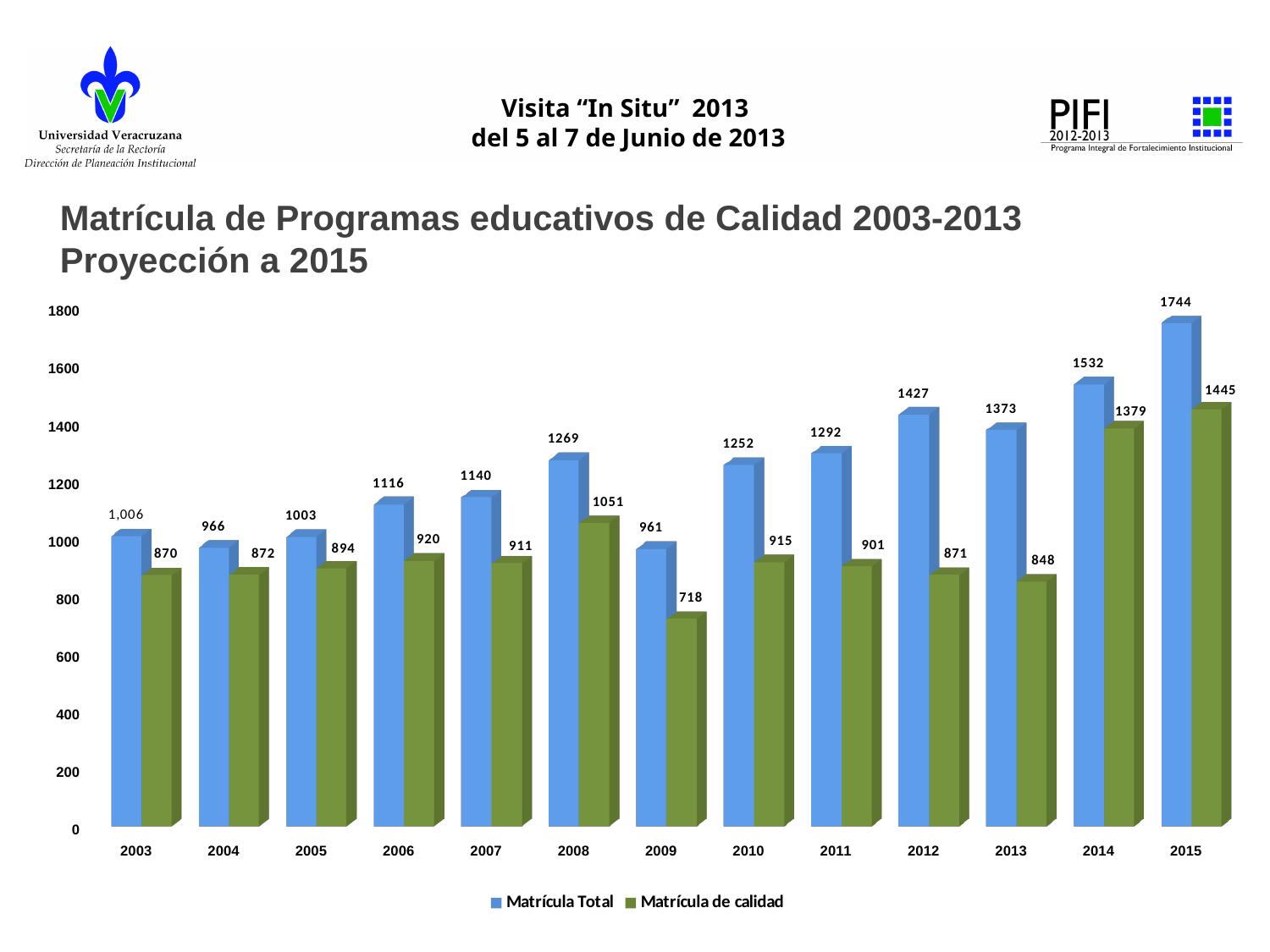
Which is larger: Matrícula de calidad in 2014 or Matrícula de calidad in 2013? 2014 What kind of chart is shown on the slide? Bar chart What is the value of Matrícula Total for 2008? 1269 What is the value of Matrícula Total for 2003? 1,006 Does Matrícula Total rise or fall from 2009 to 2015? Rise Which year has the highest Matrícula Total? 2015 What is the difference between Matrícula Total and Matrícula de calidad in 2015? 299 Which colour represents Matrícula de calidad in the legend? Green Which year has the lowest Matrícula de calidad? 2009 What is the value of Matrícula de calidad for 2009? 718 How many series does the legend list? 2 How many years are shown on the x axis? 13